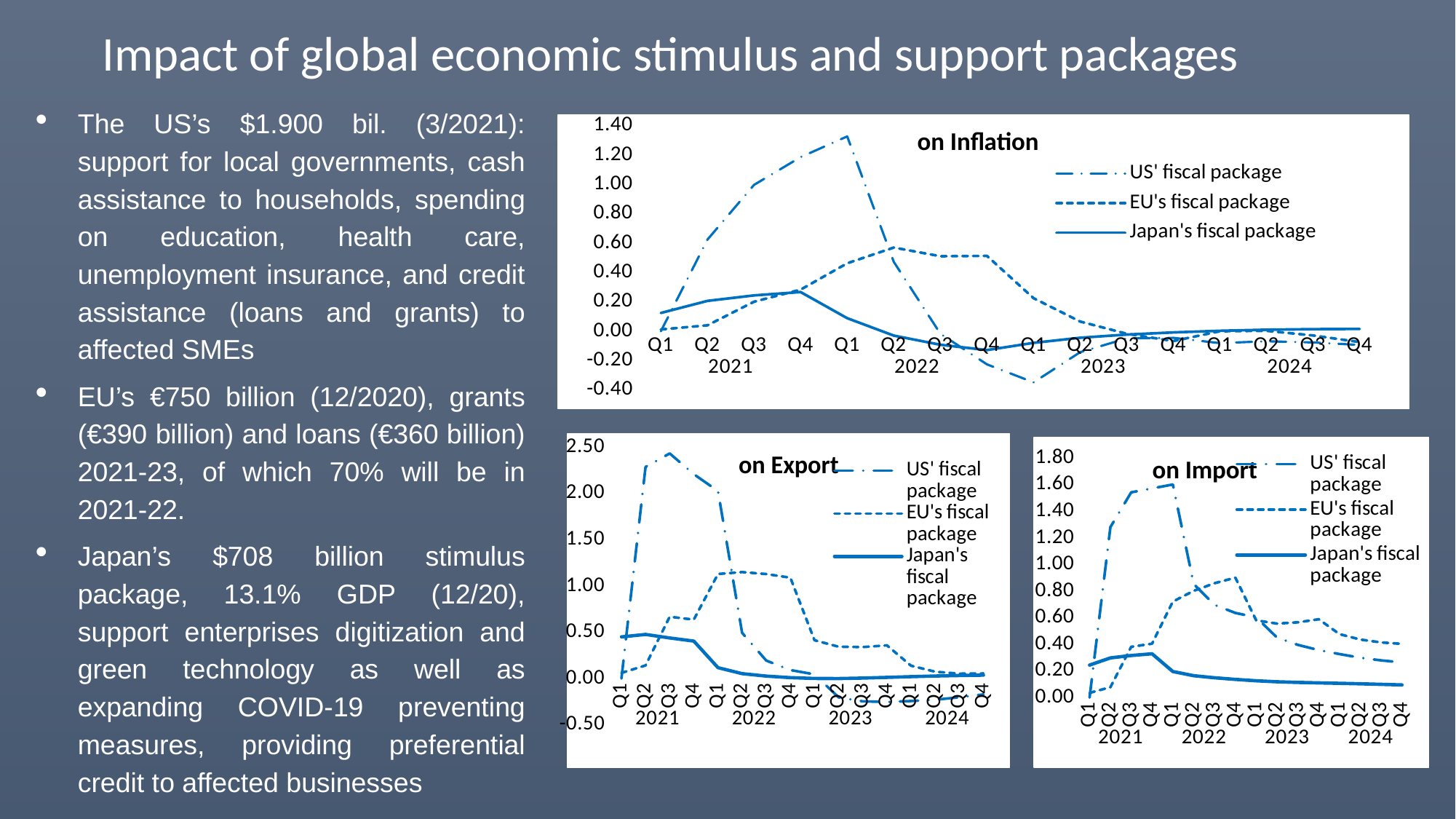
In the 'on Export' chart, does the value for Japan's fiscal package rise or fall from 2021 to 2024? fall In the 'on Export' chart, is the peak value of US' fiscal package greater or less than 2.00? greater What kind of chart is the 'on Inflation' chart? line chart In the 'on Export' chart, which series reaches the highest value? US' fiscal package In the 'on Inflation' chart, is the peak value of US' fiscal package greater or less than 1.00? greater In the 'on Import' chart, is the value for Japan's fiscal package in Q4 2021 greater or less than 0.60? less How many series does the legend of the 'on Export' chart list? 3 In the 'on Inflation' chart, which series reaches the highest value? US' fiscal package How many quarters are plotted along the x axis of the 'on Import' chart? 16 What is the title of the chart at the bottom right of the slide? on Import